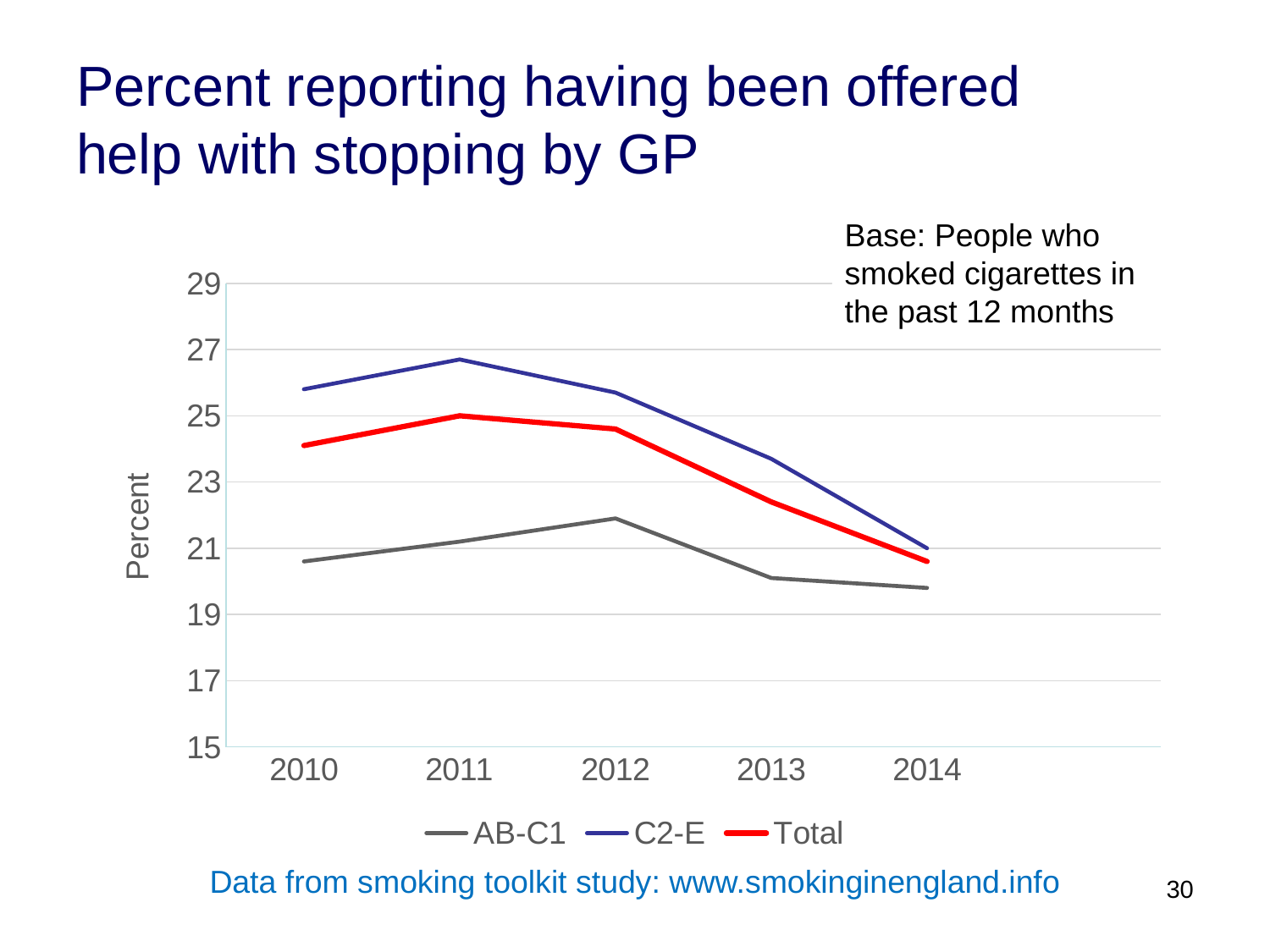
In which year is the Total series lowest? 2014 What is the label on the y axis? Percent In which year does the AB-C1 series reach its highest value? 2012 Which series has the larger value in 2012, C2-E or AB-C1? C2-E Is the value for AB-C1 in 2014 greater or less than 21? less Is the value for Total in 2013 greater or less than 23? less Is the value for C2-E in 2011 greater or less than 25? greater Does the C2-E series rise or fall from 2011 to 2014? fall How many years are shown on the x axis? 5 In which year does the C2-E series reach its highest value? 2011 How many series does the legend list? 3 What kind of chart is shown on the slide? line chart